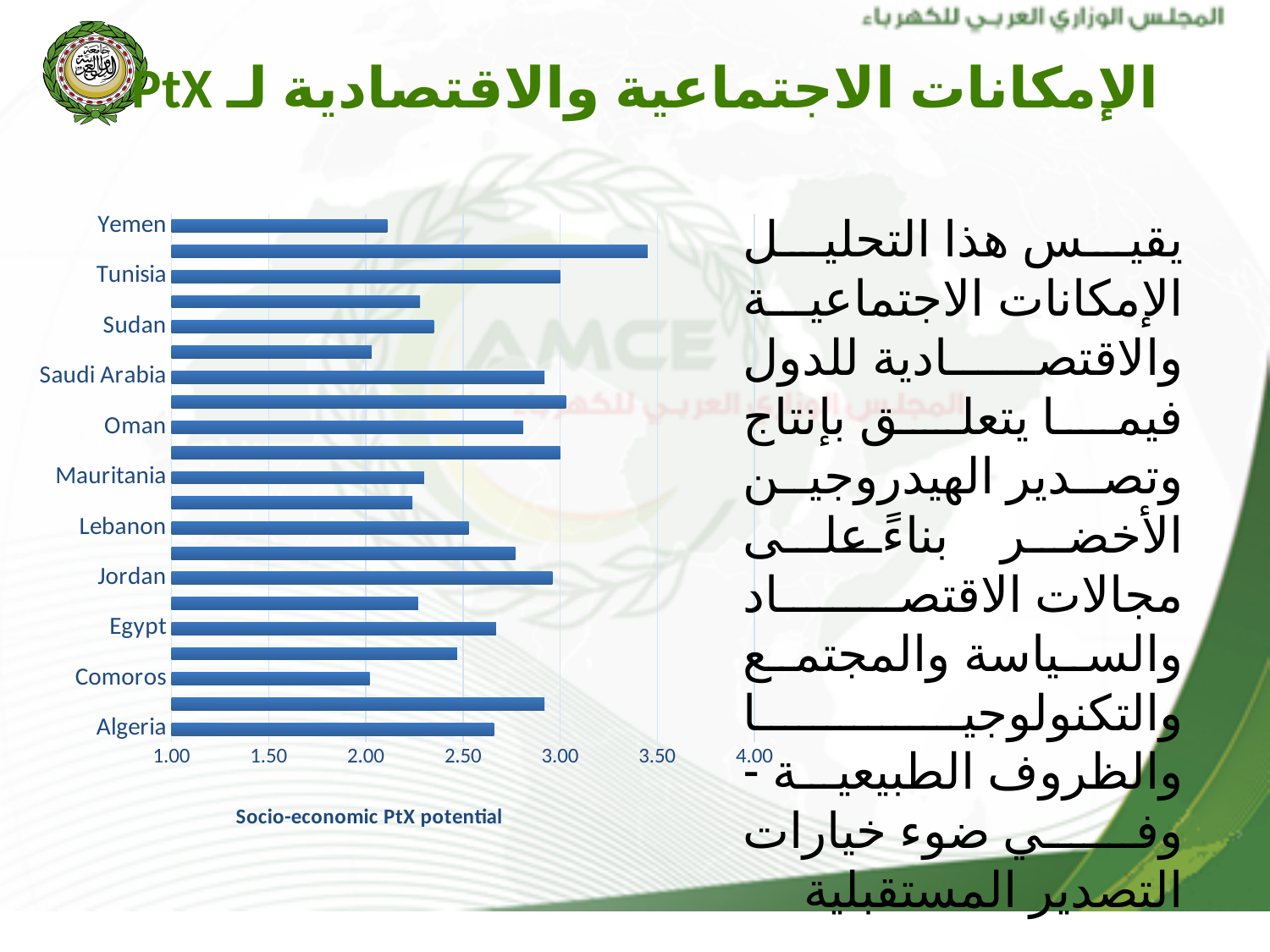
Is the value for Comoros greater or less than 2.50? less Is the value for Saudi Arabia greater or less than 2.50? greater Is the value for Yemen greater or less than 2.50? less Which has the larger value, Oman or Mauritania? Oman What is the title of the chart? Socio-economic PtX potential Which has the larger value, Tunisia or Yemen? Tunisia What kind of chart is shown on the slide? bar chart Which has the larger value, Comoros or Saudi Arabia? Saudi Arabia How many country names are labelled on the vertical axis of the chart? 11